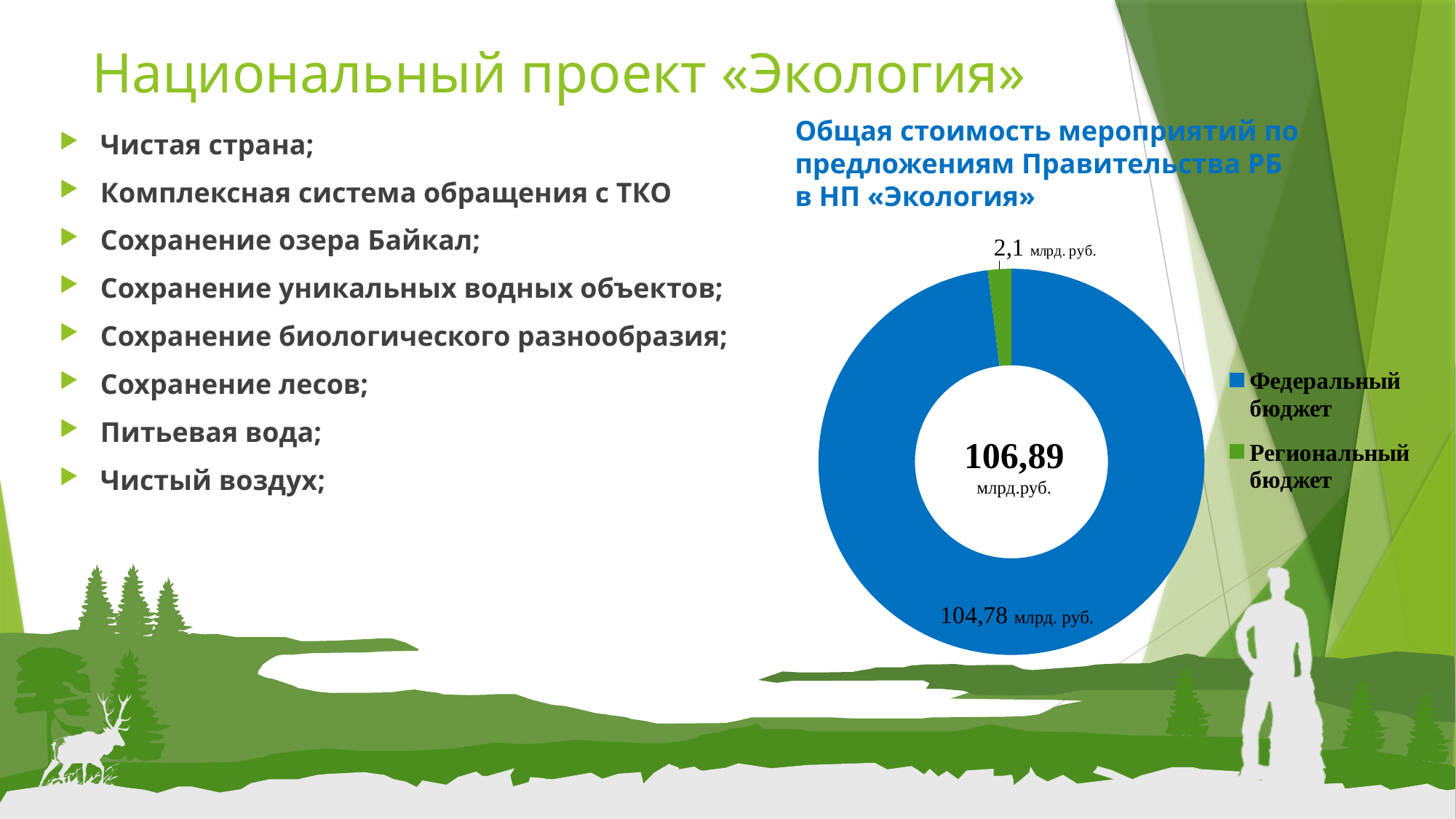
Which budget accounts for the largest slice of the chart? Федеральный бюджет What colour represents Региональный бюджет in the chart? green What is the value shown for Региональный бюджет? 2,1 млрд. руб. How many slices does the chart have? 2 What total value is printed in the centre of the doughnut chart? 106,89 млрд.руб. Which is larger, the Федеральный бюджет value or the Региональный бюджет value? Федеральный бюджет Which budget accounts for the smallest slice of the chart? Региональный бюджет What is the difference between the Федеральный бюджет and Региональный бюджет values? 102,68 млрд. руб. How many entries does the legend list? 2 What is the value shown for Федеральный бюджет? 104,78 млрд. руб. What kind of chart is shown on the slide? doughnut chart What is the title of the chart? Общая стоимость мероприятий по предложениям Правительства РБ в НП «Экология»